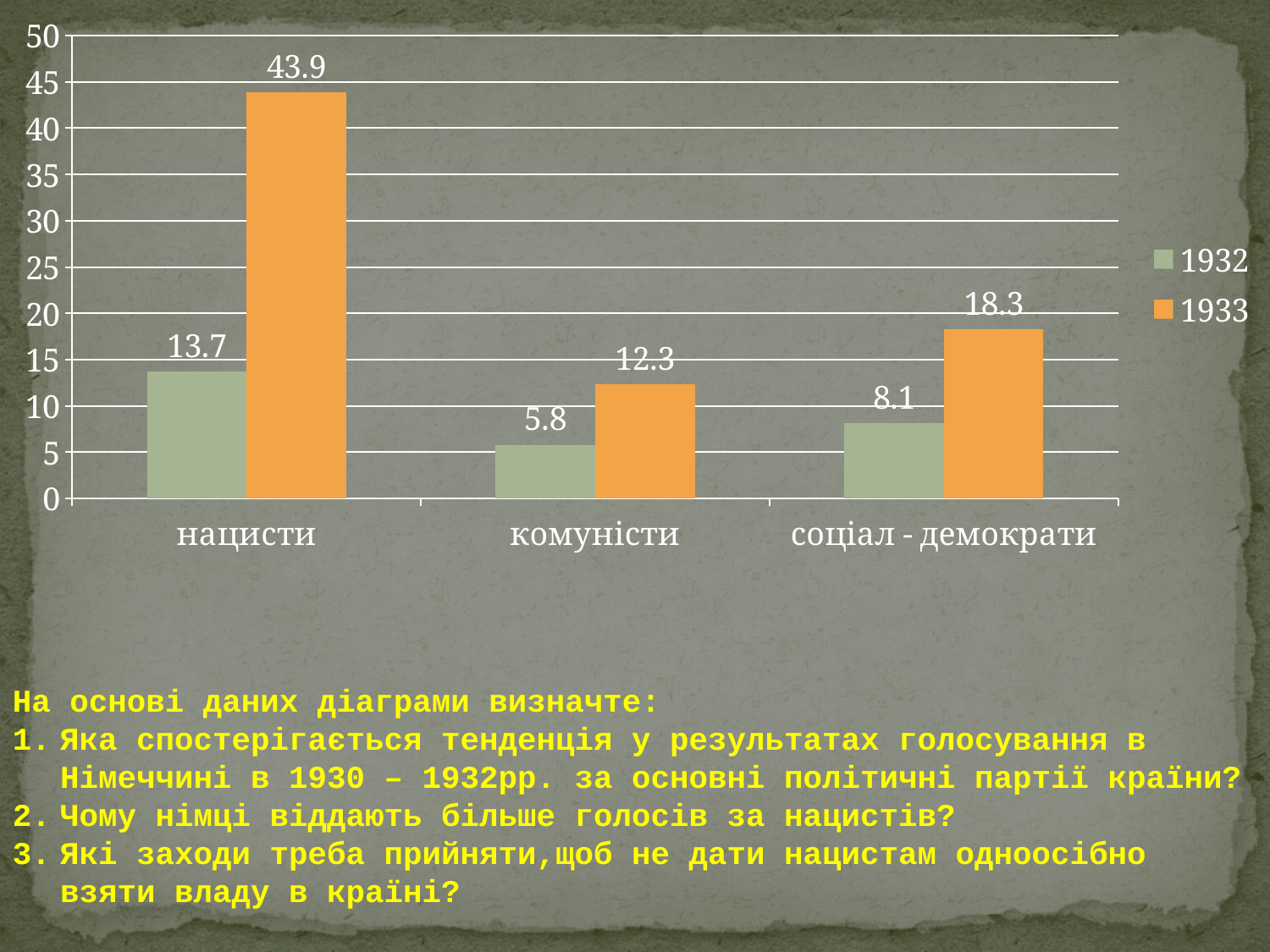
Which colour represents the 1933 series in the legend? orange How many series does the legend list? 2 What is the difference between the 1933 values for соціал - демократи and комуністи? 6 What is the difference between the 1933 and 1932 values for нацисти? 30.2 What is the value for нацисти in the 1933 series? 43.9 Which category has the lowest value in the 1932 series? комуністи What kind of chart is shown on the slide? bar chart Which category has the highest value in the 1933 series? нацисти How many categories are shown on the x axis? 3 What is the value for соціал - демократи in the 1933 series? 18.3 What is the value for комуністи in the 1932 series? 5.8 Which is larger: the 1932 value for нацисти or the 1933 value for комуністи? the 1932 value for нацисти